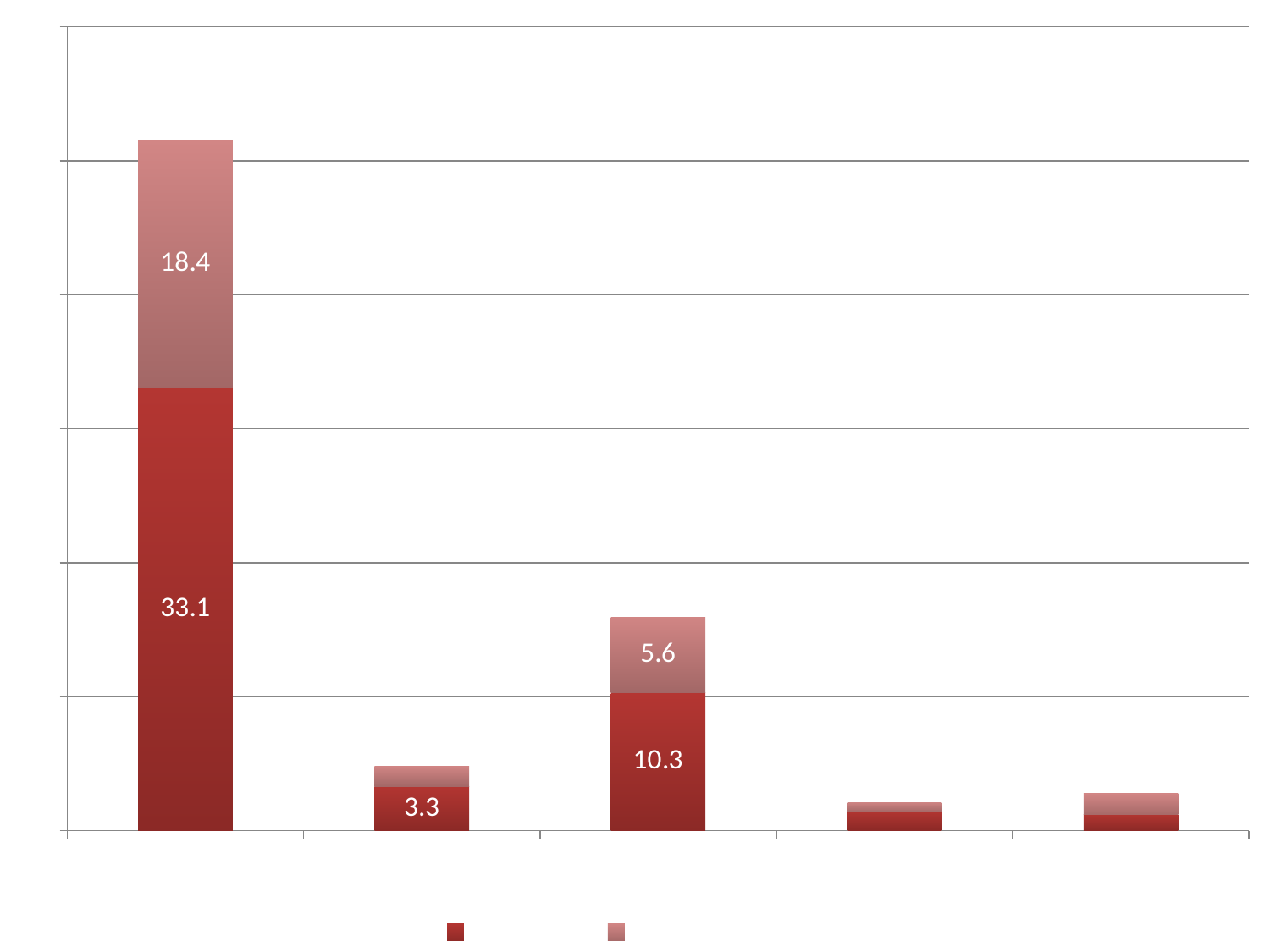
What is the difference between the dark red segments of the leftmost bar and the third bar from the left? 22.8 What is the value of the dark red segment of the second bar from the left? 3.3 How many series does the legend show? 2 What is the total of the third stacked bar from the left? 15.9 What is the value of the light red segment of the third bar from the left? 5.6 What is the value of the dark red segment of the third bar from the left? 10.3 What kind of chart is shown on the slide? stacked bar chart What is the value of the dark red segment of the leftmost bar? 33.1 Which bar is the tallest in the chart? the leftmost bar What is the value of the light red segment of the leftmost bar? 18.4 How many bars are plotted in the chart? 5 What is the total of the leftmost stacked bar? 51.5